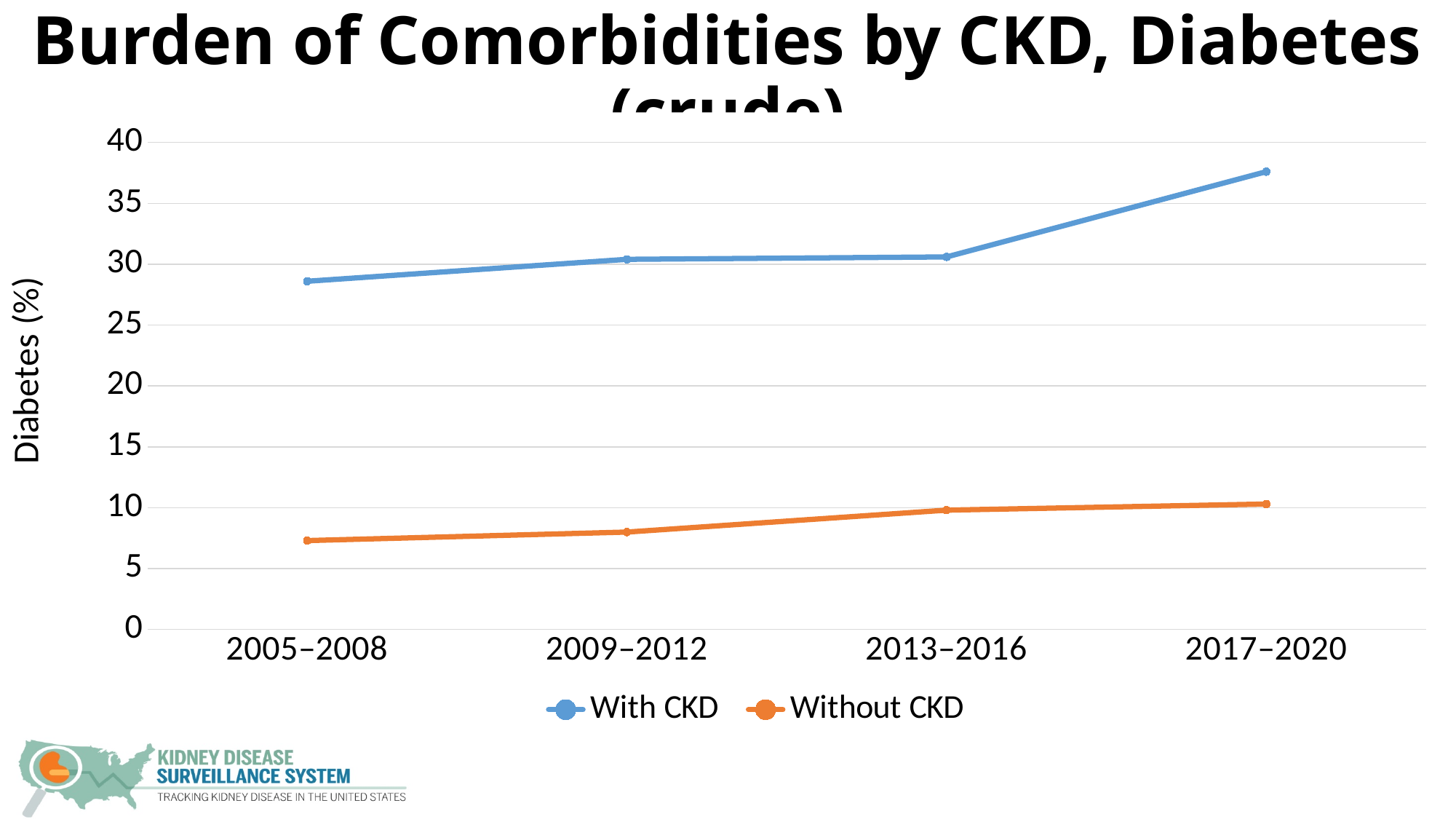
Is the value for With CKD in 2017–2020 greater or less than 35? greater What is the label on the y axis? Diabetes (%) Is the value for With CKD in 2005–2008 greater or less than 30? less How many series does the legend list? 2 Which time period has the lowest value for With CKD? 2005–2008 How many time periods are shown on the x axis? 4 What kind of chart is shown on the slide? line chart Does the With CKD line rise or fall from 2005–2008 to 2017–2020? rise Is the value for Without CKD in 2009–2012 greater or less than 10? less In 2017–2020, which series has the larger value, With CKD or Without CKD? With CKD Which time period has the highest value for With CKD? 2017–2020 Which time period has the lowest value for Without CKD? 2005–2008